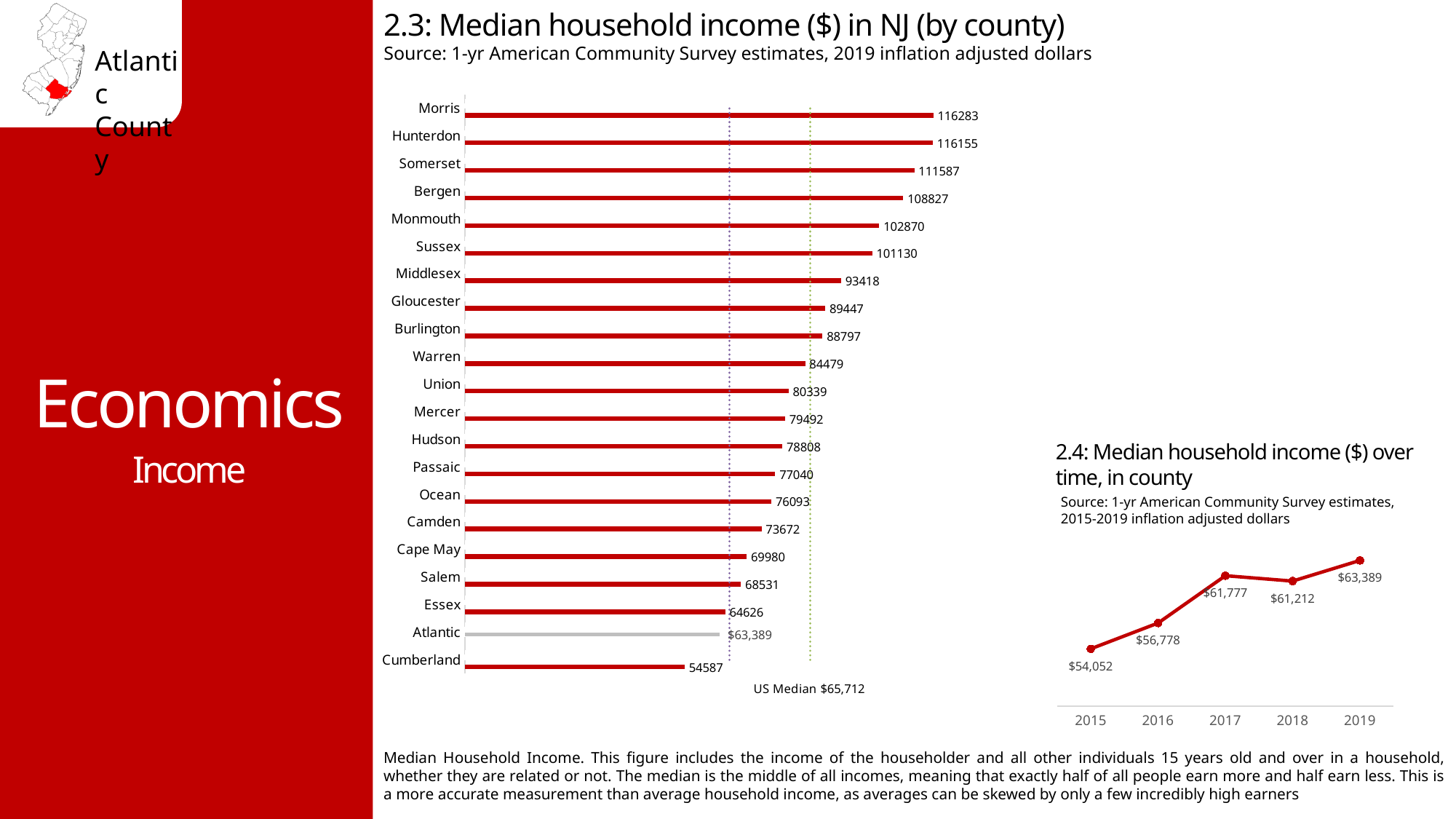
In the chart '2.3: Median household income ($) in NJ (by county)', what is the difference between the values for Bergen and Camden? 35155 What kind of chart is '2.3: Median household income ($) in NJ (by county)'? Bar chart In the chart '2.3: Median household income ($) in NJ (by county)', which county has the highest median household income? Morris In the chart '2.3: Median household income ($) in NJ (by county)', what is the value for Atlantic? $63,389 How many counties are shown in the chart '2.3: Median household income ($) in NJ (by county)'? 21 In the chart '2.3: Median household income ($) in NJ (by county)', which has a higher value, Gloucester or Burlington? Gloucester In the chart '2.4: Median household income ($) over time, in county', what is the value for 2017? $61,777 What kind of chart is '2.4: Median household income ($) over time, in county'? Line chart In the chart '2.4: Median household income ($) over time, in county', which year has the lowest value? 2015 In the chart '2.3: Median household income ($) in NJ (by county)', which county has the lowest median household income? Cumberland In the chart '2.3: Median household income ($) in NJ (by county)', what is the value for Morris? 116283 In the chart '2.4: Median household income ($) over time, in county', what is the difference between the 2019 and 2015 values? $9,337